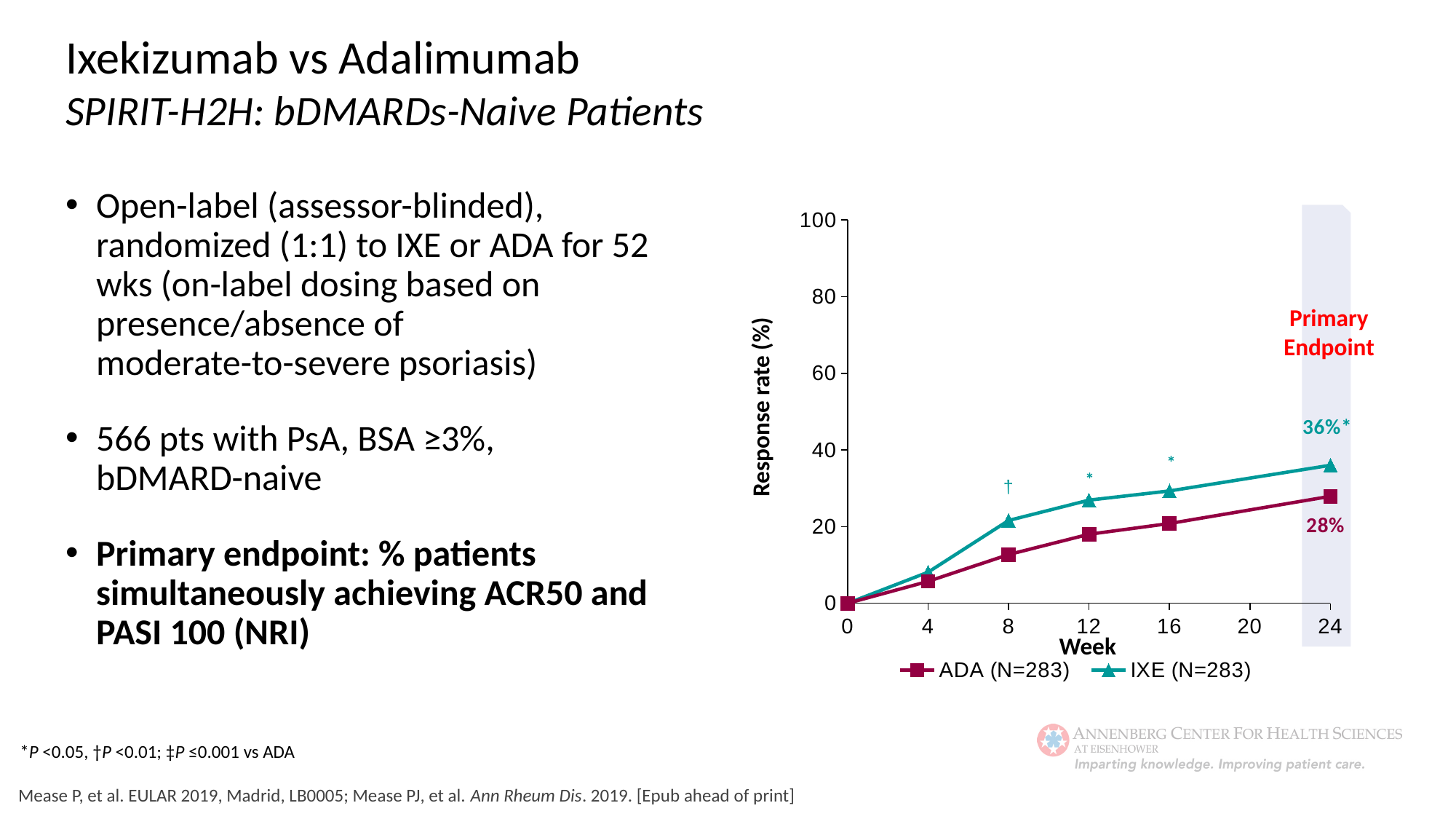
At week 24, which series has the higher response rate, IXE or ADA? IXE What is the difference between the IXE and ADA response rates at week 24? 8 percentage points Which week is highlighted as the Primary Endpoint on the chart? Week 24 What kind of chart is shown on the slide? Line chart How many series does the legend list? 2 What is the response rate for IXE (N=283) at week 24? 36% What is the label of the y axis? Response rate (%) Is the response rate for IXE at week 16 greater or less than 40? less Is the response rate for ADA at week 8 greater or less than 20? less Do the response rates for IXE rise or fall from week 0 to week 24? Rise Is the response rate for IXE at week 12 greater or less than 20? greater What is the response rate for ADA (N=283) at week 24? 28%